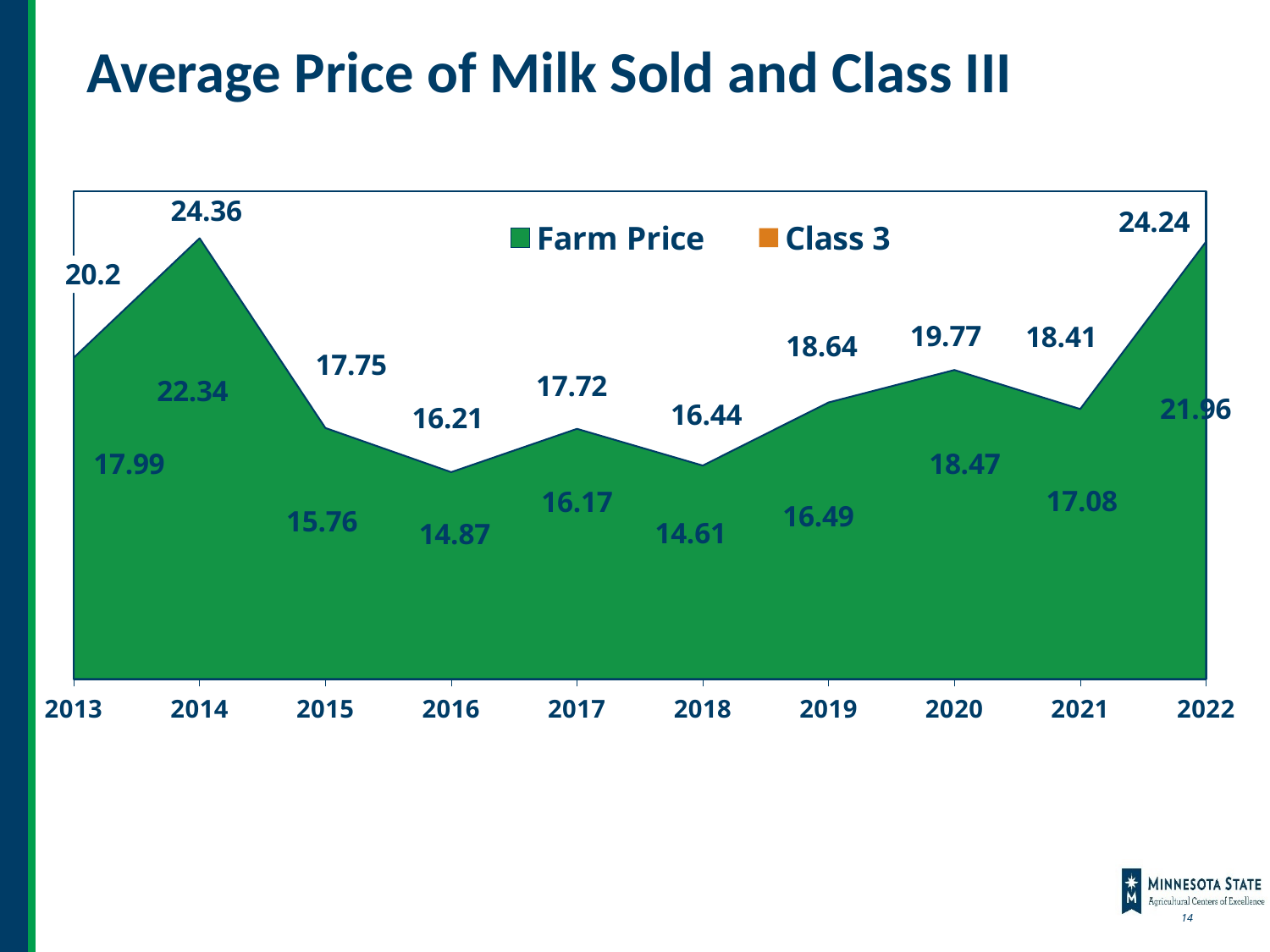
What is the Class 3 value for 2018? 14.61 Which is larger, the Farm Price in 2020 or the Farm Price in 2021? 2020 How many series does the legend list? 2 Which year has the highest Farm Price? 2014 What is the Farm Price value for 2014? 24.36 What kind of chart is shown on the slide? Area chart Which year has the lowest Class 3 value? 2018 What is the difference between the Farm Price and the Class 3 value in 2013? 2.21 Does the Farm Price rise or fall from 2014 to 2016? Fall What is the Class 3 value for 2020? 18.47 How many years are shown on the x axis? 10 What is the Farm Price value for 2022? 24.24